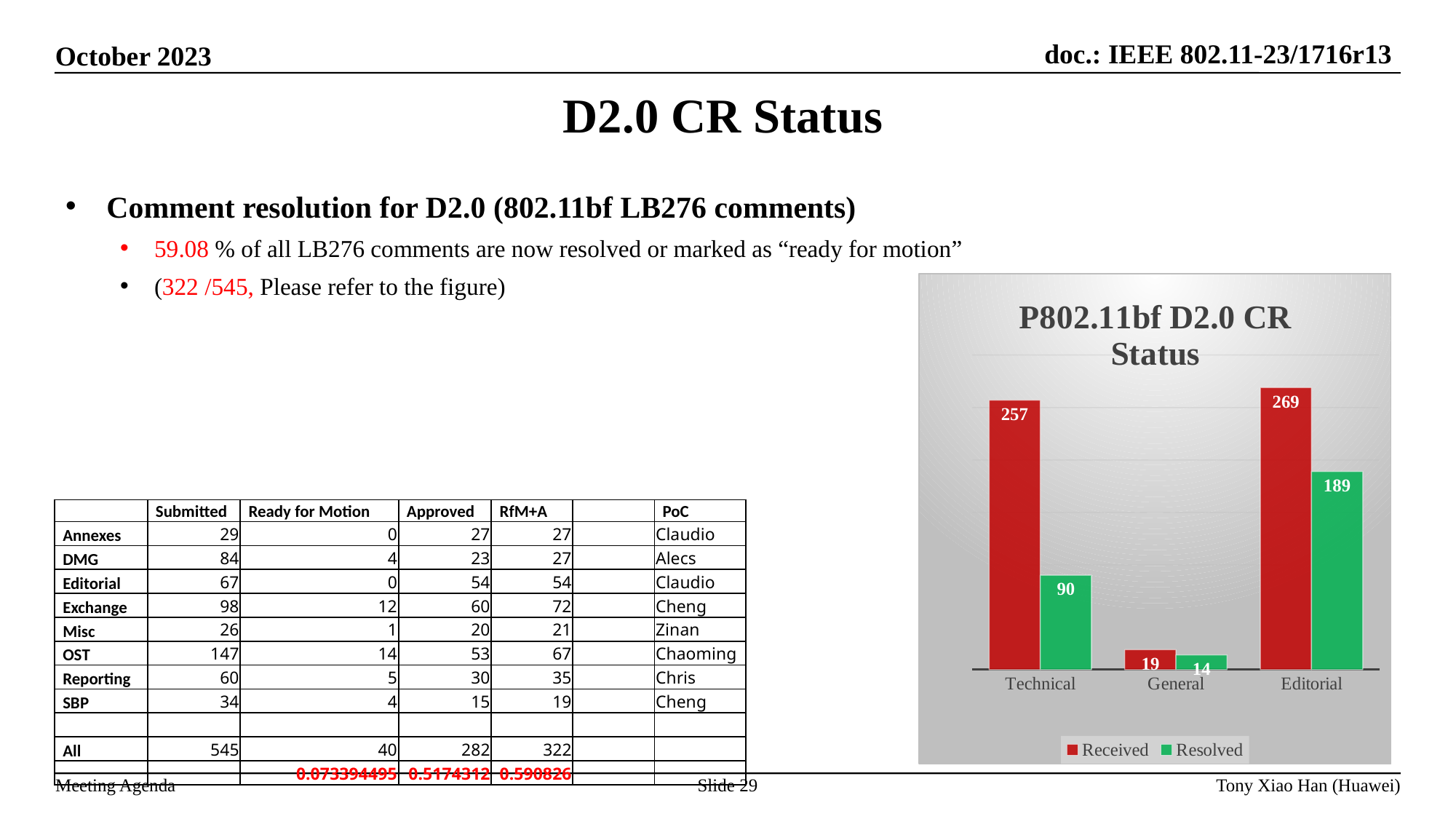
What is the title of the chart? P802.11bf D2.0 CR Status Which category has the lowest Resolved value? General How many series does the chart legend list? 2 What is the Resolved value for Editorial? 189 What is the Resolved value for General? 14 How many categories are shown on the x axis of the chart? 3 What type of chart is shown on the slide? bar chart Which is larger, the Resolved value for Technical or the Resolved value for Editorial? Editorial Which category has the highest Received value? Editorial Which colour represents the Resolved series in the chart? green What is the Received value for Technical? 257 What is the difference between Received and Resolved for Technical? 167